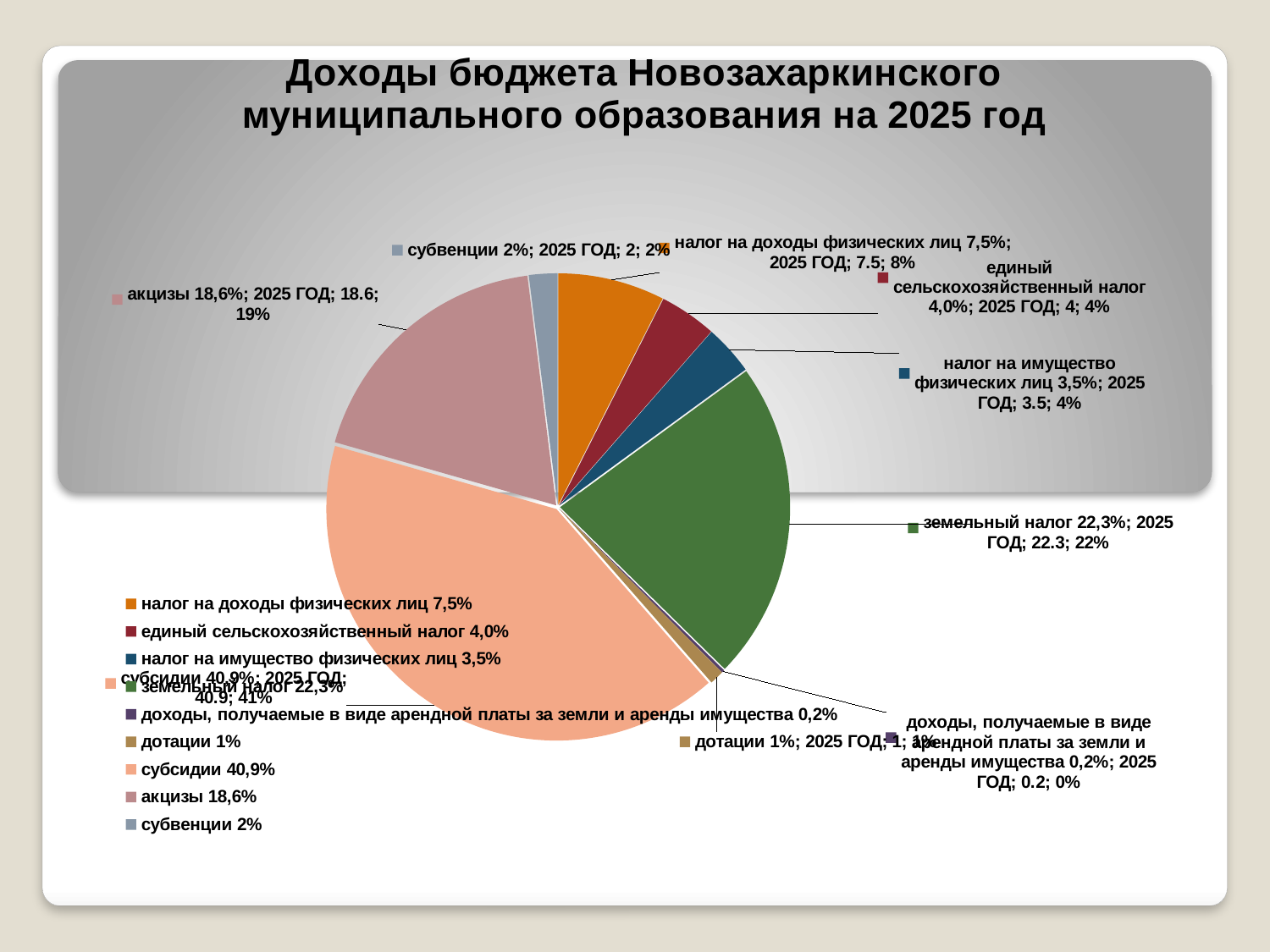
Which is larger: the value for налог на доходы физических лиц or the value for единый сельскохозяйственный налог? налог на доходы физических лиц What is the title of the chart on the slide? Доходы бюджета Новозахаркинского муниципального образования на 2025 год What kind of chart is shown on the slide? pie chart What percentage share of the pie is shown for акцизы? 19% How many categories (slices) does the pie chart have? 9 What is the difference between the values for земельный налог (22.3) and акцизы (18.6)? 3.7 What percentage share of the pie is shown for субсидии? 41% Which category has the largest slice of the pie chart? субсидии What value is shown for субсидии in the data label? 40.9 Which category has the smallest slice of the pie chart? доходы, получаемые в виде арендной платы за земли и аренды имущества What value is shown for акцизы in the data label? 18.6 What value is shown for земельный налог in the data label? 22.3